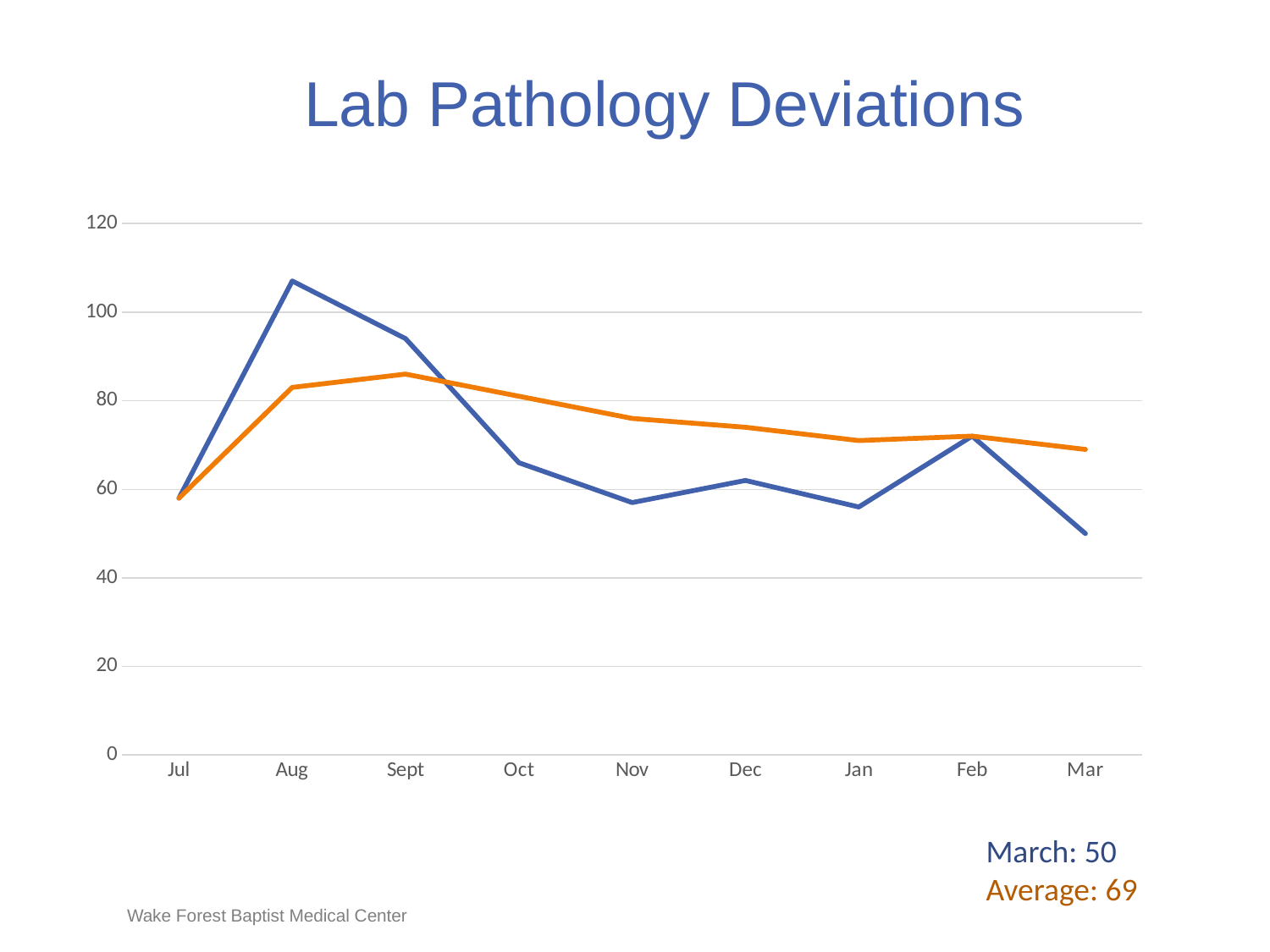
What is the value of the blue line for Mar? 50 Does the blue line rise or fall from Aug to Nov? fall What kind of chart is shown on the slide? line chart In which month does the blue line reach its lowest value? Mar What is the value of the orange average line for Mar? 69 In which month does the blue line reach its highest value? Aug What is the difference between the average (69) and the March value (50)? 19 Is the value of the blue line for Aug greater or less than 100? greater What is the title of the chart? Lab Pathology Deviations How many months are plotted along the x axis? 9 Is the value of the orange line for Nov greater or less than 80? less In Aug, which line has the larger value, the blue line or the orange line? blue